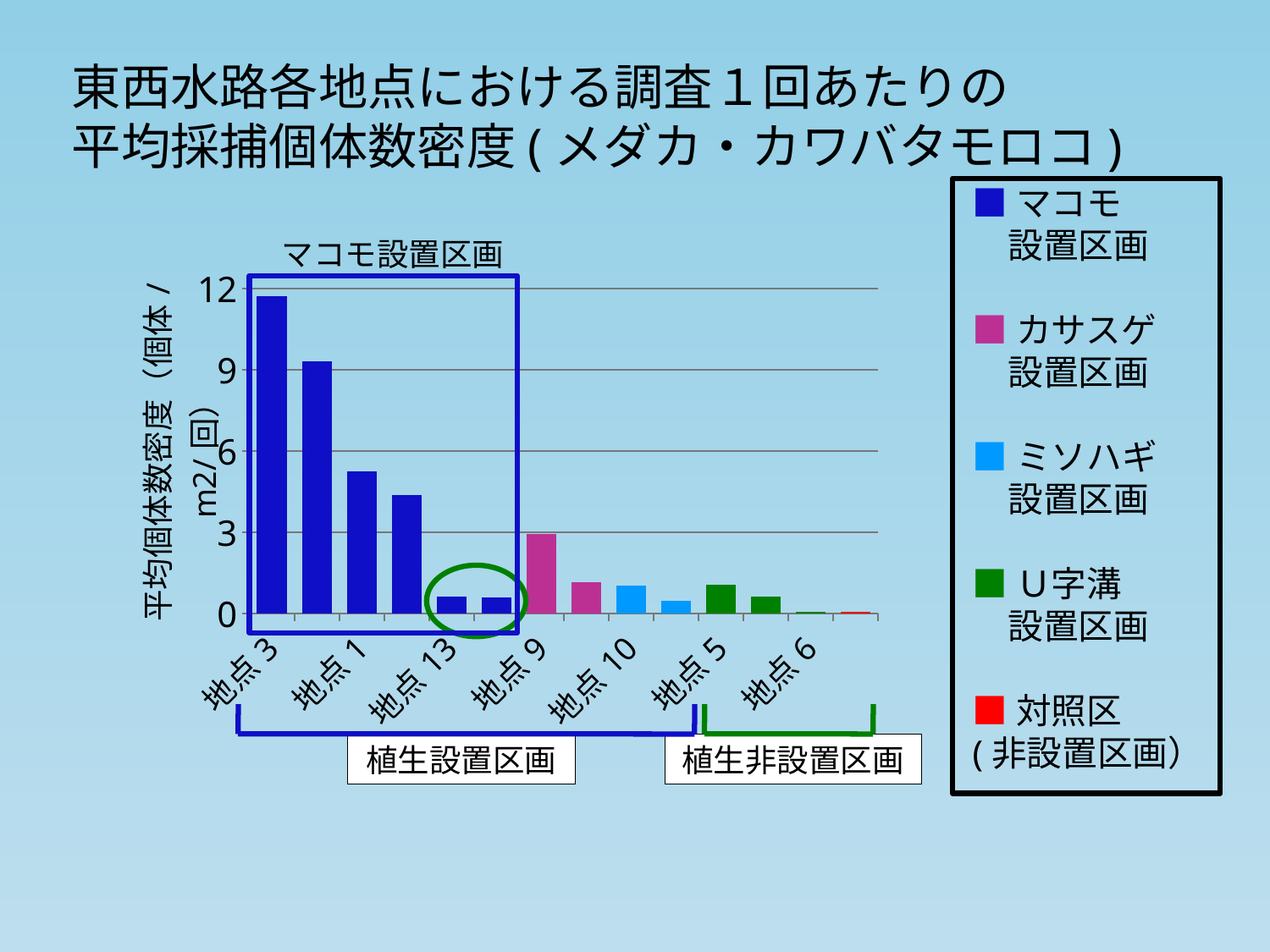
Which is larger, the value for 地点1 or the value for 地点9? 地点1 Is the value for 地点3 greater or less than 9? greater What kind of chart is shown on the slide? bar chart Is the value for 地点10 greater or less than 3? less How many series does the legend list? 5 What colour represents マコモ設置区画 in the legend? blue Which site has the highest average individual density? 地点3 Is the value for 地点1 greater or less than 6? less What is the highest tick value shown on the y axis? 12 Do the bar values generally rise or fall from left to right along the x axis? fall Which is larger, the value for 地点3 or the value for 地点1? 地点3